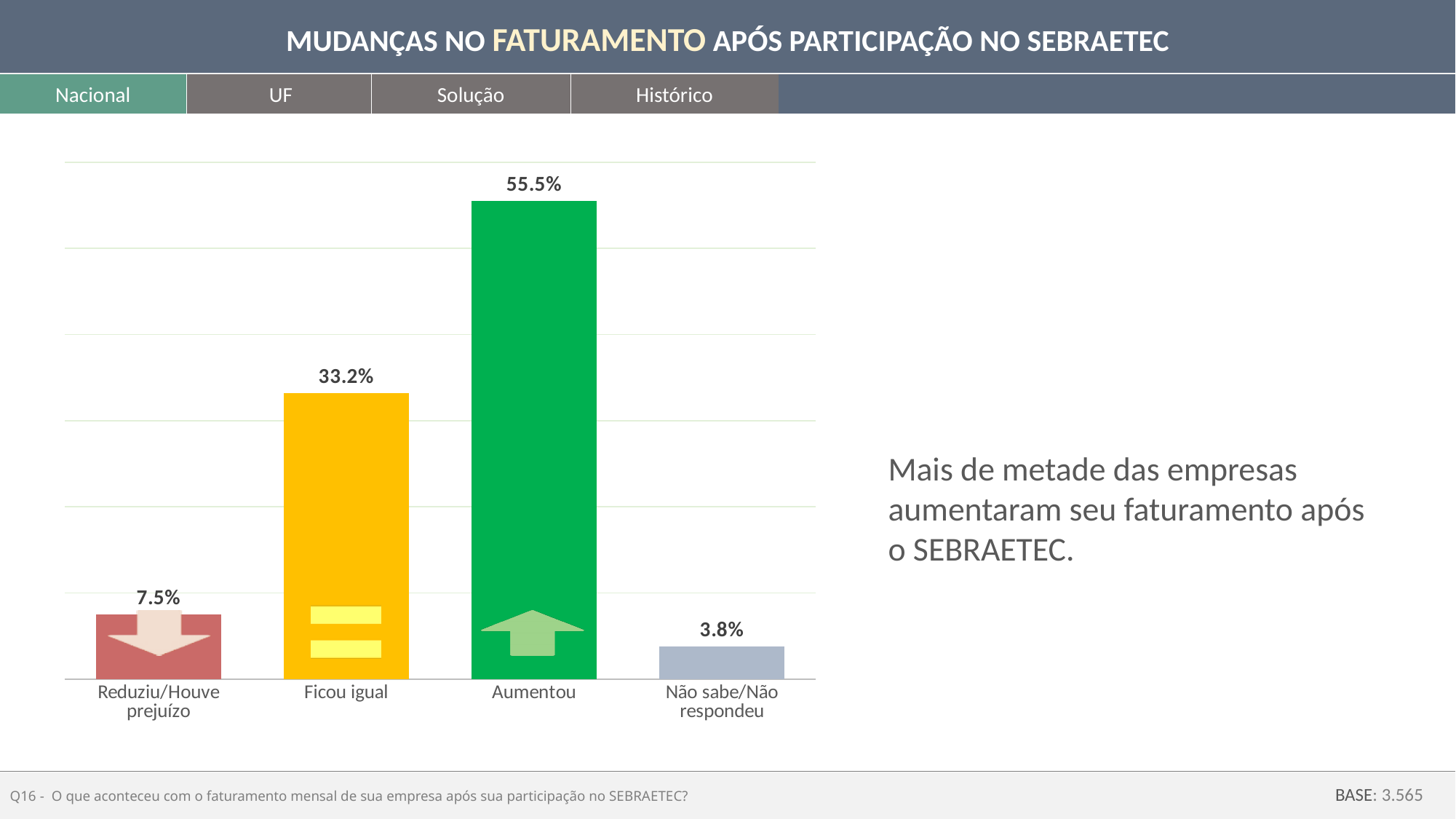
What is the value for "Aumentou"? 55.5% What colour is the bar for "Aumentou"? Green How many categories are shown in the chart? 4 What is the difference between the values for "Reduziu/Houve prejuízo" and "Não sabe/Não respondeu"? 3.7% What is the difference between the values for "Aumentou" and "Ficou igual"? 22.3% What is the value for "Não sabe/Não respondeu"? 3.8% Which is larger, the value for "Ficou igual" or the value for "Reduziu/Houve prejuízo"? Ficou igual What kind of chart is shown on the slide? Bar chart What is the value for "Ficou igual"? 33.2% What is the value for "Reduziu/Houve prejuízo"? 7.5% Which category has the highest value? Aumentou Which category has the lowest value? Não sabe/Não respondeu